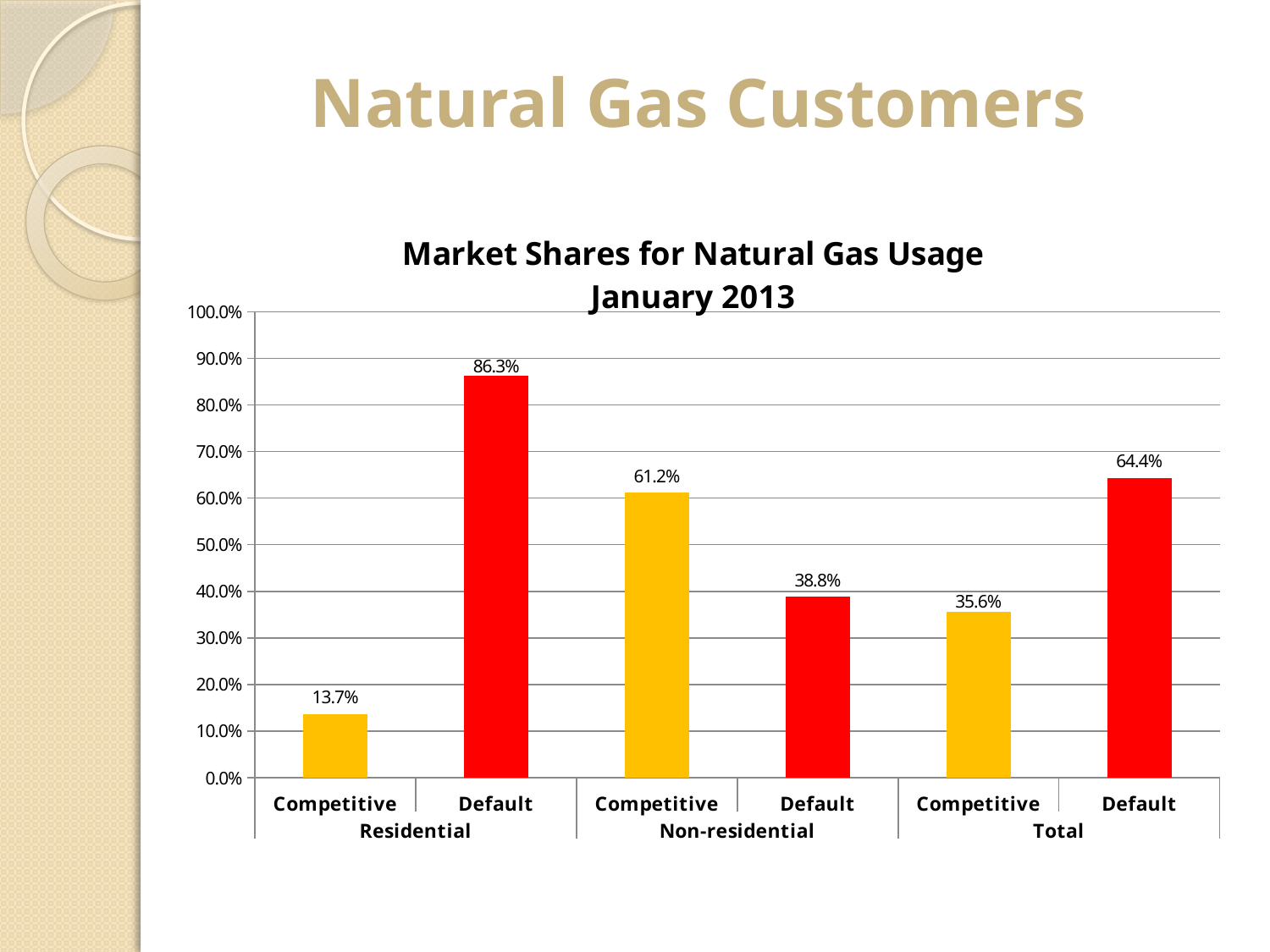
What is the title of the chart? Market Shares for Natural Gas Usage January 2013 Which bar has the highest value on the chart? Residential Default Which bar has the lowest value on the chart? Residential Competitive How many bars are plotted on the chart? 6 What kind of chart is shown on the slide? Bar chart What is the difference between the Competitive and Default shares in the Non-residential group? 22.4% Which is larger: the Competitive share for Non-residential or the Competitive share for Total? Non-residential What is the difference between the Default and Competitive shares in the Residential group? 72.6% What is the market share for Default in the Non-residential group? 38.8% What is the market share for Competitive in the Total group? 35.6% What is the market share for Competitive in the Residential group? 13.7% Is the value for Total Default greater or less than 60.0%? greater